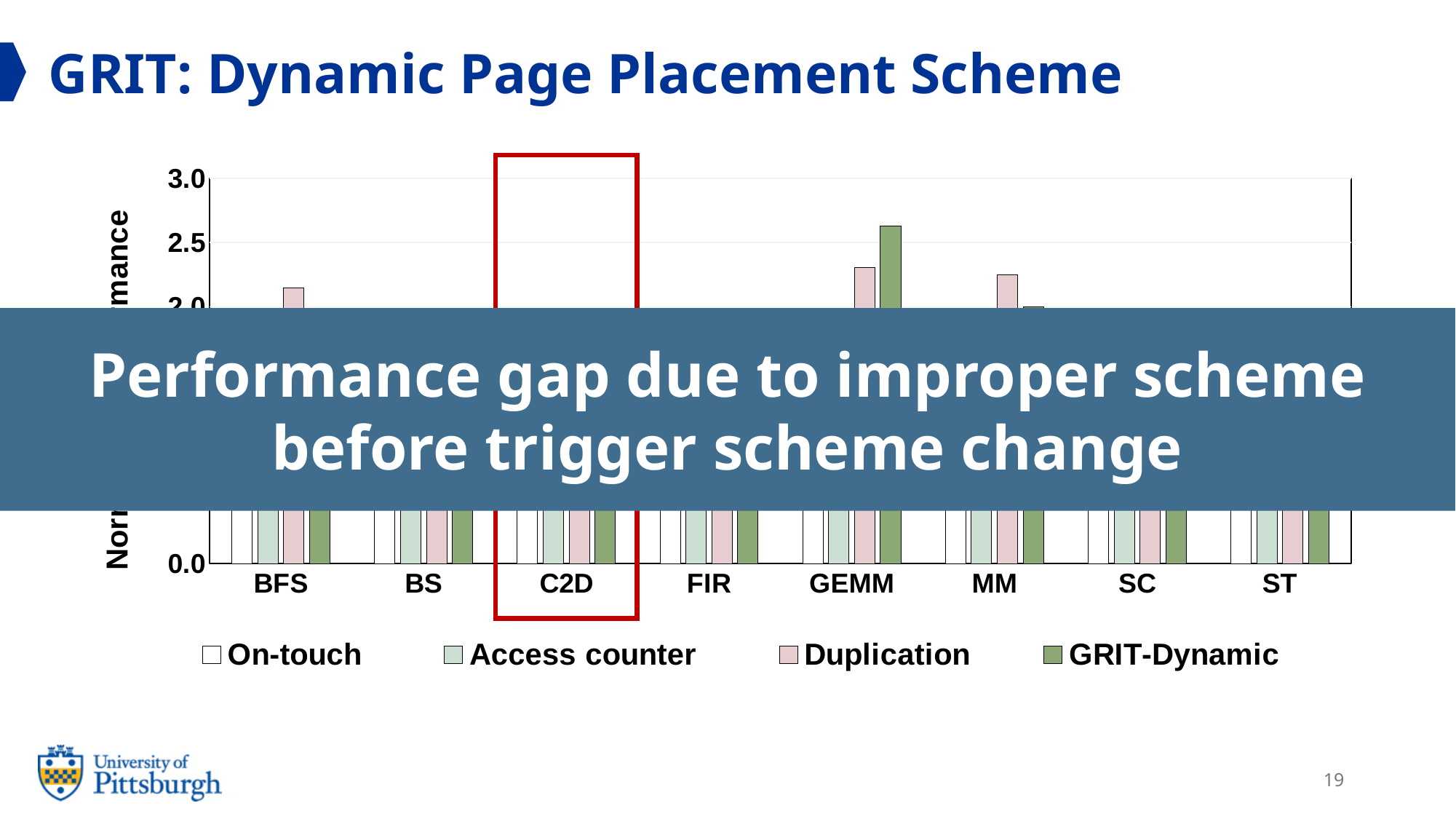
What is the last series listed in the chart's legend? GRIT-Dynamic For MM, which is larger: the Duplication value or the GRIT-Dynamic value? Duplication Which category is highlighted with a red box on the chart? C2D How many categories are shown along the x axis of the chart? 8 Which category has the highest GRIT-Dynamic value? GEMM Is the GRIT-Dynamic value for GEMM greater or less than 2.5? greater Is the Duplication value for MM greater or less than 2.0? greater Is the Duplication value for GEMM greater or less than 2.5? less How many series does the chart's legend list? 4 What kind of chart is shown on the slide? bar chart For GEMM, which is larger: the Duplication value or the GRIT-Dynamic value? GRIT-Dynamic